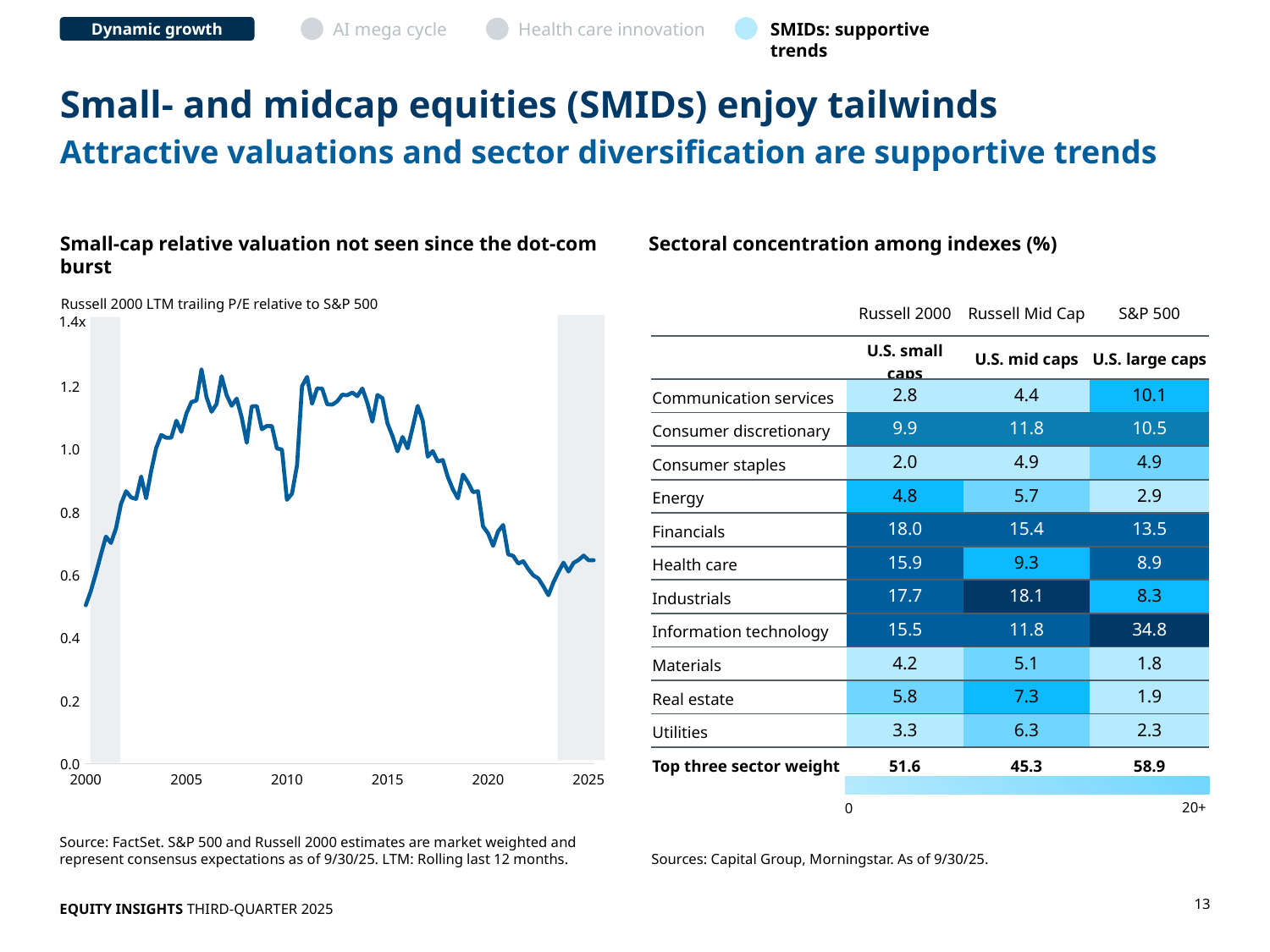
In the left chart, is the value at the start of 2000 greater or less than 0.6? less In the 'Sectoral concentration among indexes (%)' chart, which sector has the lowest weight in the S&P 500? Materials What kind of chart is the left chart, 'Small-cap relative valuation not seen since the dot-com burst'? line chart In the left chart, is the value at 2025 greater or less than 0.8? less In the 'Sectoral concentration among indexes (%)' chart, what is the Financials weight for the Russell 2000? 18.0 In the 'Sectoral concentration among indexes (%)' chart, what is the Information technology weight for the S&P 500? 34.8 In the 'Sectoral concentration among indexes (%)' chart, which index has the larger Health care weight, Russell 2000 or Russell Mid Cap? Russell 2000 How many sectors are listed in the 'Sectoral concentration among indexes (%)' chart? 11 In the 'Sectoral concentration among indexes (%)' chart, what is the difference between the Industrials weight in the Russell 2000 and in the S&P 500? 9.4 In the left chart, does the Russell 2000 relative P/E rise or fall between 2015 and 2023? fall In the 'Sectoral concentration among indexes (%)' chart, which sector has the highest weight in the Russell Mid Cap? Industrials In the left chart, is the value around 2013 greater or less than 1.0? greater